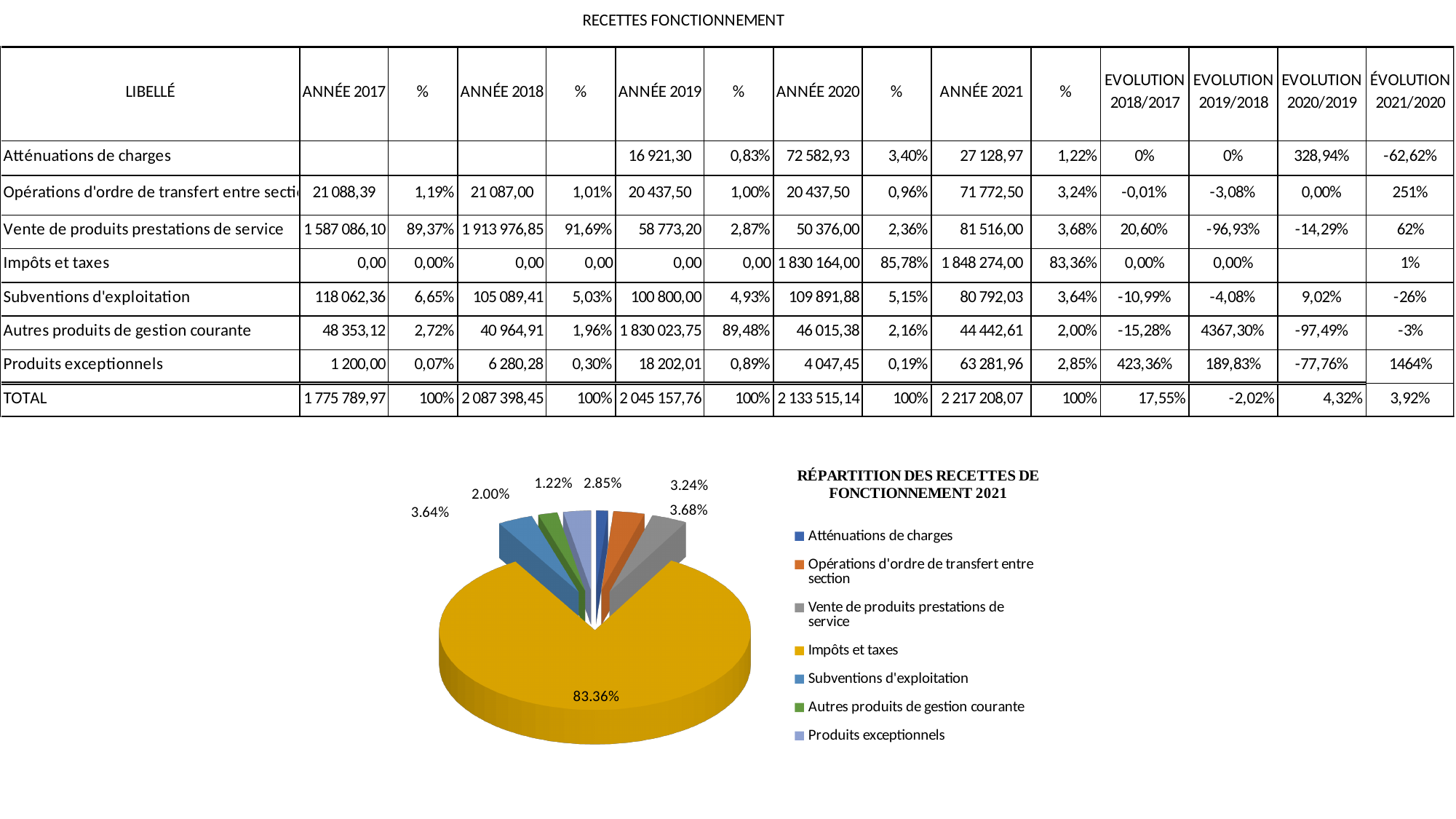
In the pie chart, what share is shown for Impôts et taxes? 83.36% In the pie chart, what is the difference between the share of Opérations d'ordre de transfert entre section and the share of Autres produits de gestion courante? 1.24% What is the title of the pie chart? RÉPARTITION DES RECETTES DE FONCTIONNEMENT 2021 What colour is the Impôts et taxes slice in the pie chart? yellow In the pie chart, what share is shown for Atténuations de charges? 1.22% How many categories does the pie chart legend list? 7 In the pie chart, what share is shown for Produits exceptionnels? 2.85% In the pie chart, which is larger: Vente de produits prestations de service or Autres produits de gestion courante? Vente de produits prestations de service Which category has the largest slice in the pie chart? Impôts et taxes What type of chart is shown on the slide? pie chart Which category has the smallest slice in the pie chart? Atténuations de charges